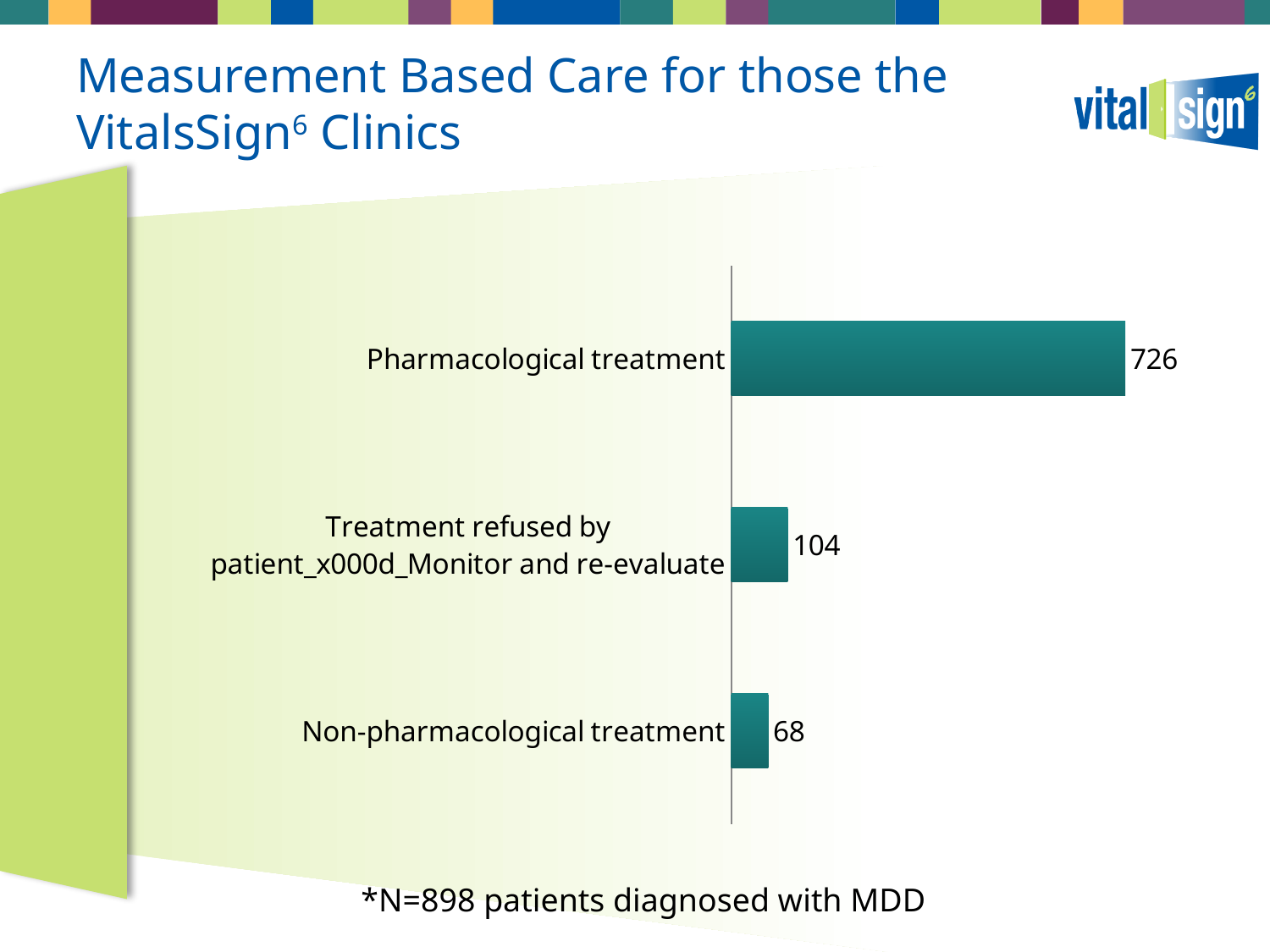
What kind of chart is shown on the slide? Bar chart Which category has the lowest value? Non-pharmacological treatment Which category has the highest value? Pharmacological treatment How many categories are shown in the chart? 3 According to the note below the chart, how many patients were diagnosed with MDD? 898 What is the difference between the values for Pharmacological treatment and Non-pharmacological treatment? 658 What is the value for Pharmacological treatment? 726 Which is larger: the value for Treatment refused by patient or the value for Non-pharmacological treatment? Treatment refused by patient What is the difference between the values for Treatment refused by patient and Non-pharmacological treatment? 36 What is the value for Non-pharmacological treatment? 68 What is the value for Treatment refused by patient / Monitor and re-evaluate? 104 What is the total of the three values shown in the chart? 898